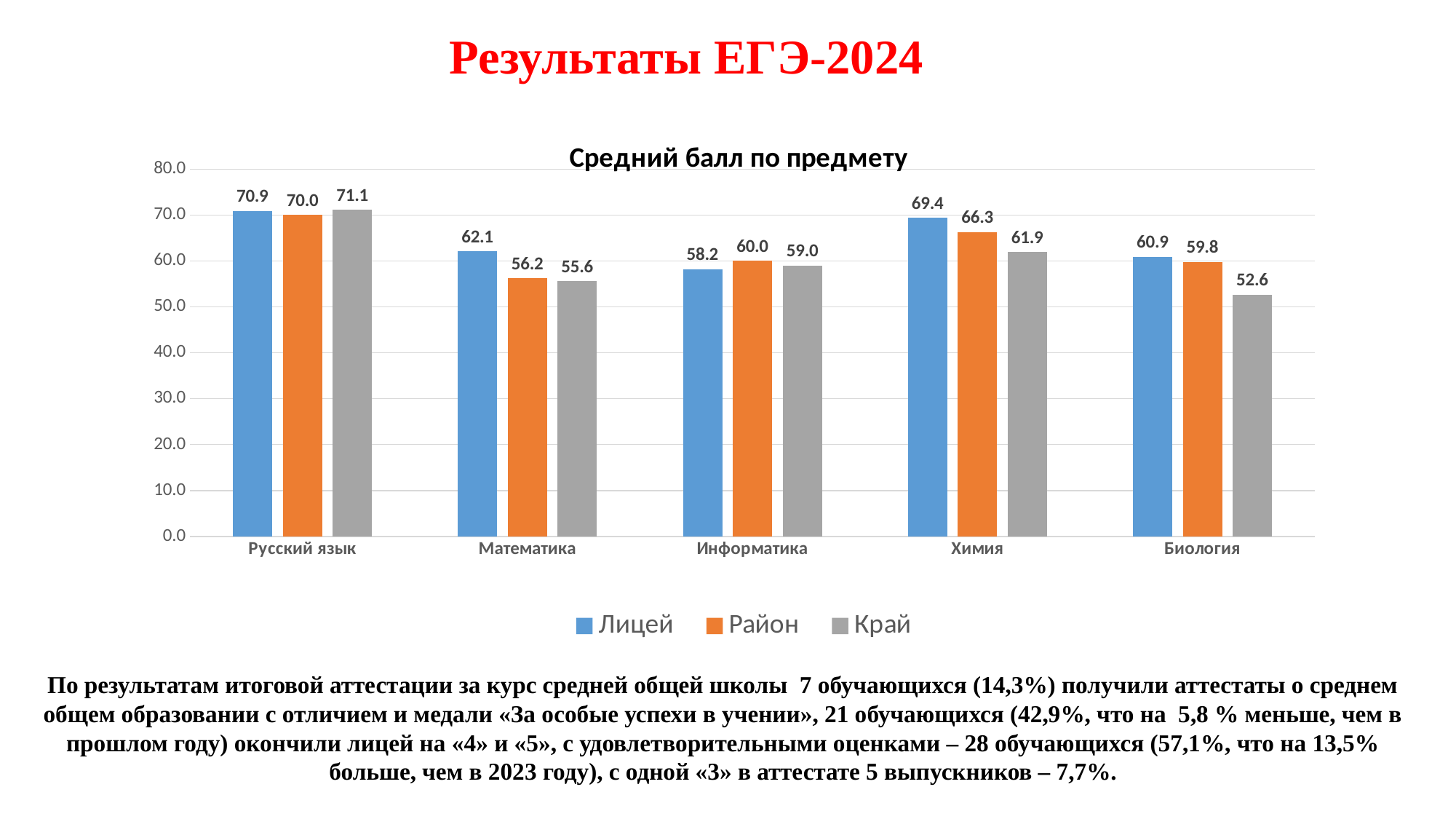
What is the average score for Район in Химия? 66.3 What is the average score for Лицей in Математика? 62.1 Which subject has the highest Лицей score? Русский язык Which subject has the lowest Край score? Биология What is the title of the chart? Средний балл по предмету Is the Край value for Химия greater or less than 60.0? greater How many subjects are shown on the x axis? 5 How many series does the legend list? 3 What is the average score for Край in Биология? 52.6 What is the difference between the Лицей and Район scores in Математика? 5.9 What kind of chart is shown? bar chart Which is larger in Информатика: the Лицей score or the Район score? Район